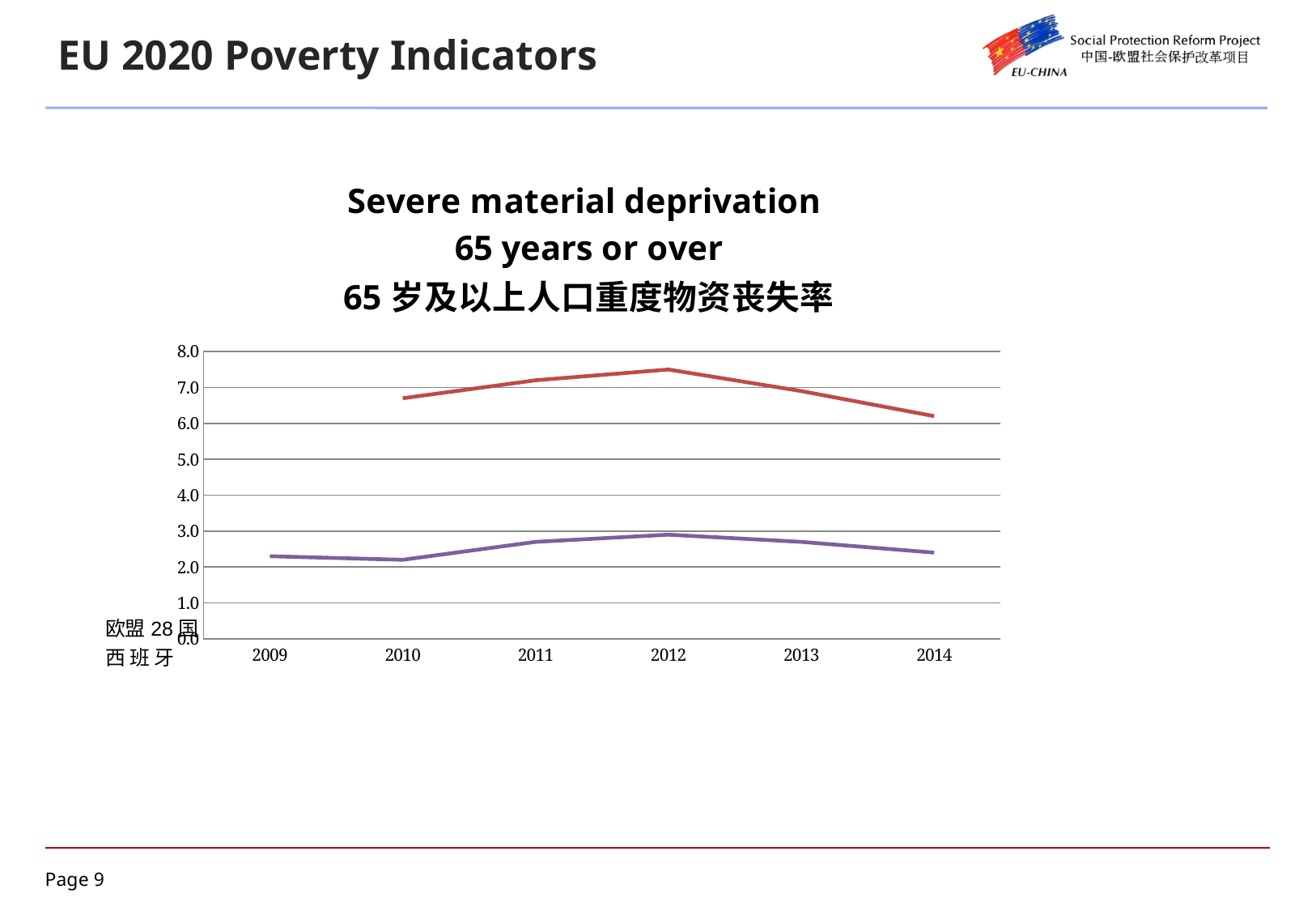
Is the value of the red line in 2012 greater or less than 7.0? greater Is the value of the purple line in 2009 greater or less than 2.0? greater In which year does the red line reach its lowest value? 2014 What is the title of the chart? Severe material deprivation 65 years or over 65 岁及以上人口重度物资丧失率 What kind of chart is shown on the slide? line chart In 2012, which line has the higher value, the red line or the purple line? the red line In which year does the red line reach its highest value? 2012 Is the value of the red line in 2010 greater or less than 7.0? less Does the red line rise or fall between 2012 and 2014? fall How many years are shown on the x axis of the chart? 6 In which year does the purple line reach its highest value? 2012